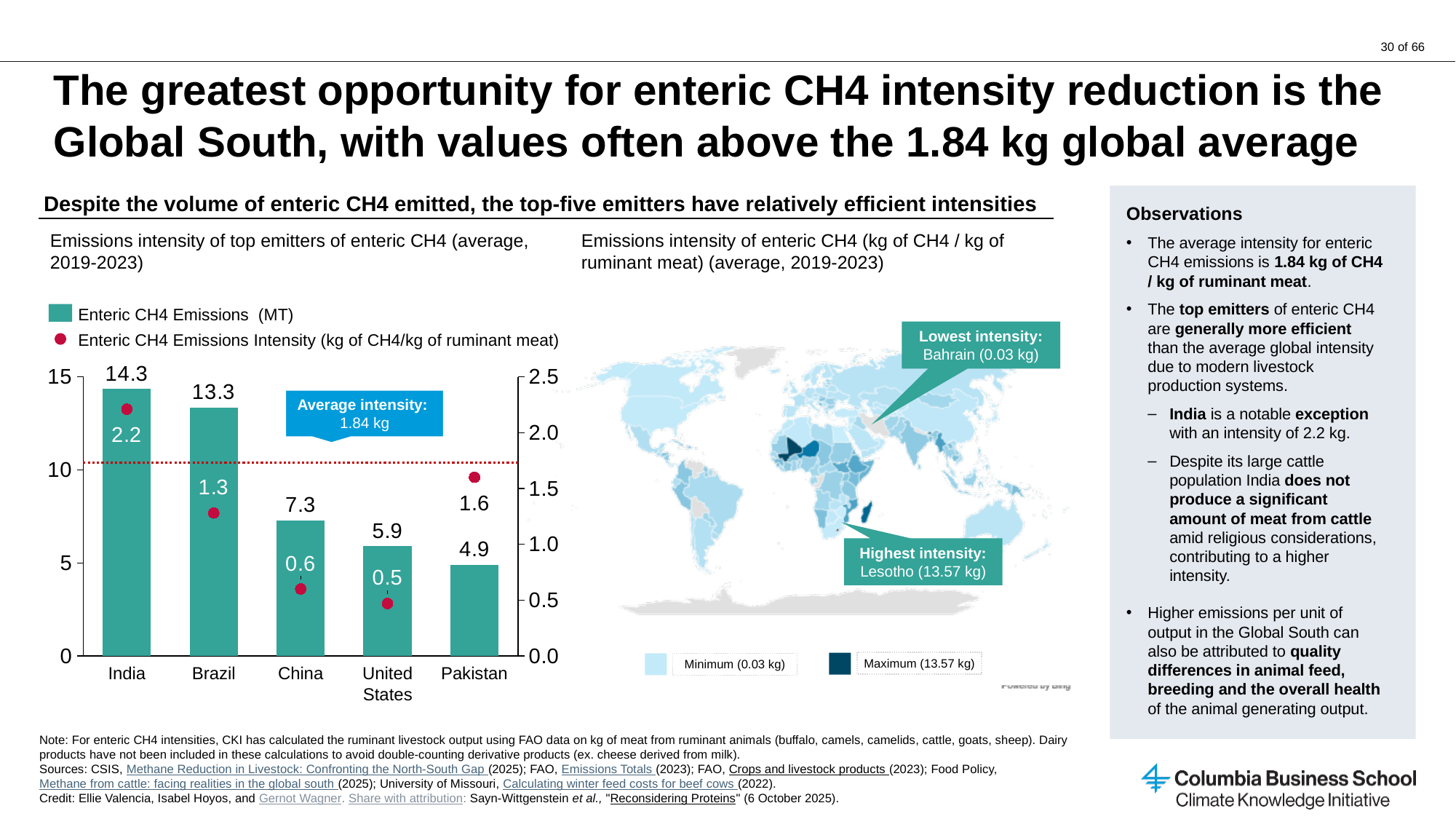
In the bar chart on the left, what average intensity value is marked by the dotted line? 1.84 kg In the map on the right, which country has the highest enteric CH4 intensity and what is its value? Lesotho (13.57 kg) In the bar chart on the left, what is the enteric CH4 emissions intensity for Brazil? 1.3 In the bar chart on the left, which has a higher enteric CH4 emissions intensity, Pakistan or Brazil? Pakistan In the bar chart on the left, which country has the lowest enteric CH4 emissions (MT)? Pakistan What type of chart is shown on the left of the slide? Combination chart (bars with dot markers) In the bar chart on the left, how many countries are shown on the x axis? 5 In the bar chart on the left, which country has the lowest enteric CH4 emissions intensity? United States In the bar chart on the left, what is the enteric CH4 emissions value (MT) for India? 14.3 In the bar chart on the left, what is the difference in enteric CH4 emissions (MT) between India and Brazil? 1.0 In the bar chart on the left, how many series does the legend list? 2 In the bar chart on the left, which country has the highest enteric CH4 emissions (MT)? India